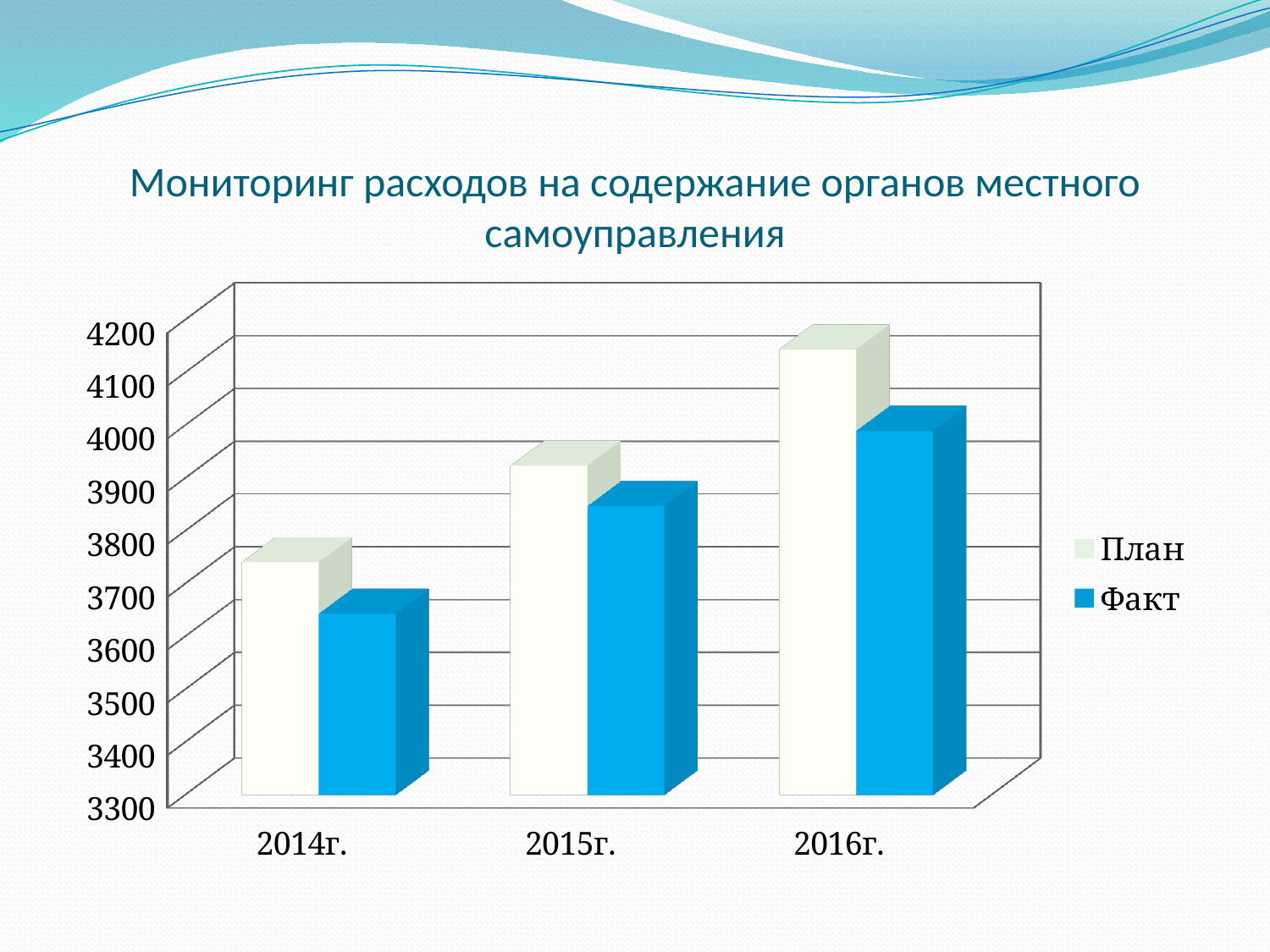
What is the title of the chart? Мониторинг расходов на содержание органов местного самоуправления Is the План value for 2014г. greater or less than 3700? greater What kind of chart is shown on the slide? bar chart Is the Факт value for 2015г. greater or less than 3900? less Is the Факт value for 2014г. greater or less than 3700? less How many categories (years) are shown on the x axis? 3 How many series does the legend list? 2 In 2014г., which is larger: План or Факт? План Do the Факт values rise or fall from 2014г. to 2016г.? rise Which year has the lowest Факт value? 2014г. Which year has the highest План value? 2016г.